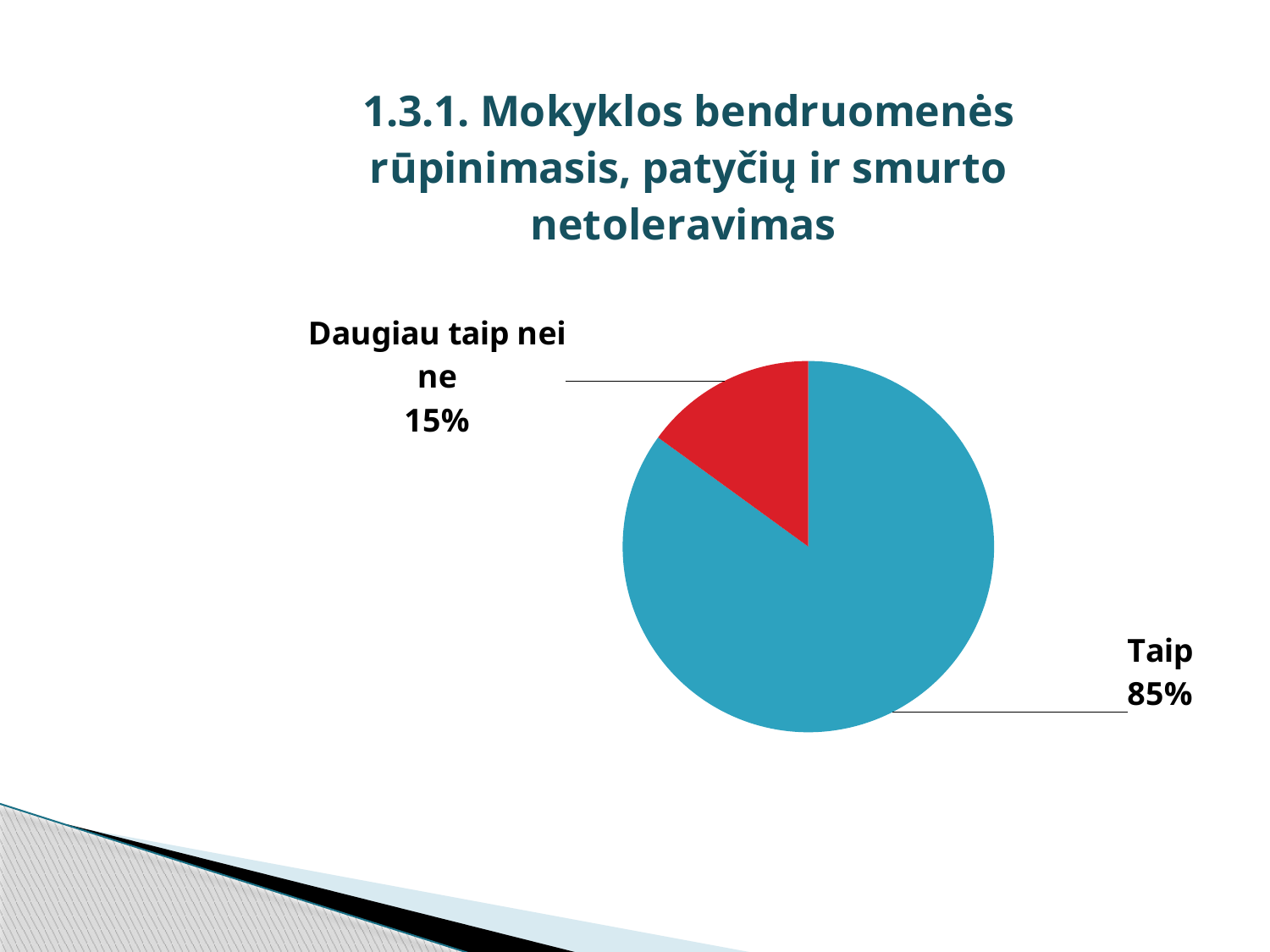
What is the total of the two slice percentages shown on the pie chart? 100% Which is larger, the "Taip" slice or the "Daugiau taip nei ne" slice? Taip What share of the pie does "Taip" represent? 85% What kind of chart is shown on the slide? pie chart How many slices does the pie chart have? 2 What colour is the "Daugiau taip nei ne" slice? red Which slice of the pie is the smallest? Daugiau taip nei ne What share of the pie does "Daugiau taip nei ne" represent? 15% Which slice of the pie is the largest? Taip What colour is the "Taip" slice? blue What is the difference in percentage points between the "Taip" slice and the "Daugiau taip nei ne" slice? 70 percentage points